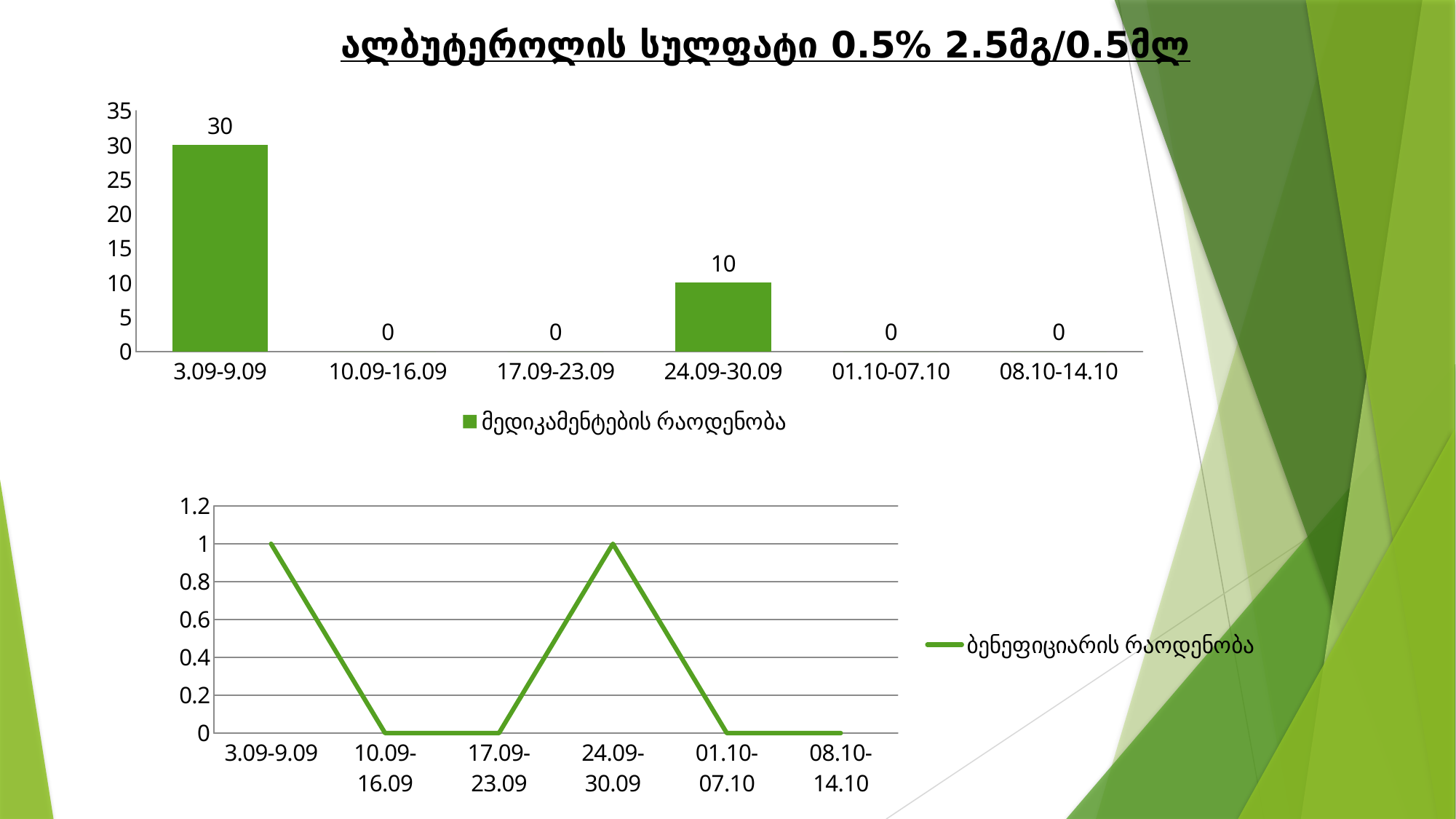
In the top bar chart, what is the difference between the values for 3.09-9.09 and 24.09-30.09? 20 In the top bar chart, how many categories have a value of 0? 4 In the bottom line chart, what is the value for 01.10-07.10? 0 In the bottom line chart, is the value for 3.09-9.09 larger or smaller than the value for 10.09-16.09? larger What kind of chart is the top chart on the slide? bar chart What kind of chart is the bottom chart on the slide? line chart In the top bar chart, what is the value for 24.09-30.09? 10 In the top bar chart, how many categories are shown on the x axis? 6 In the bottom line chart, what is the value for 24.09-30.09? 1 How many series does the legend of the bottom line chart list? 1 In the top bar chart, what is the value for 3.09-9.09? 30 In the top bar chart, which category has the highest value? 3.09-9.09